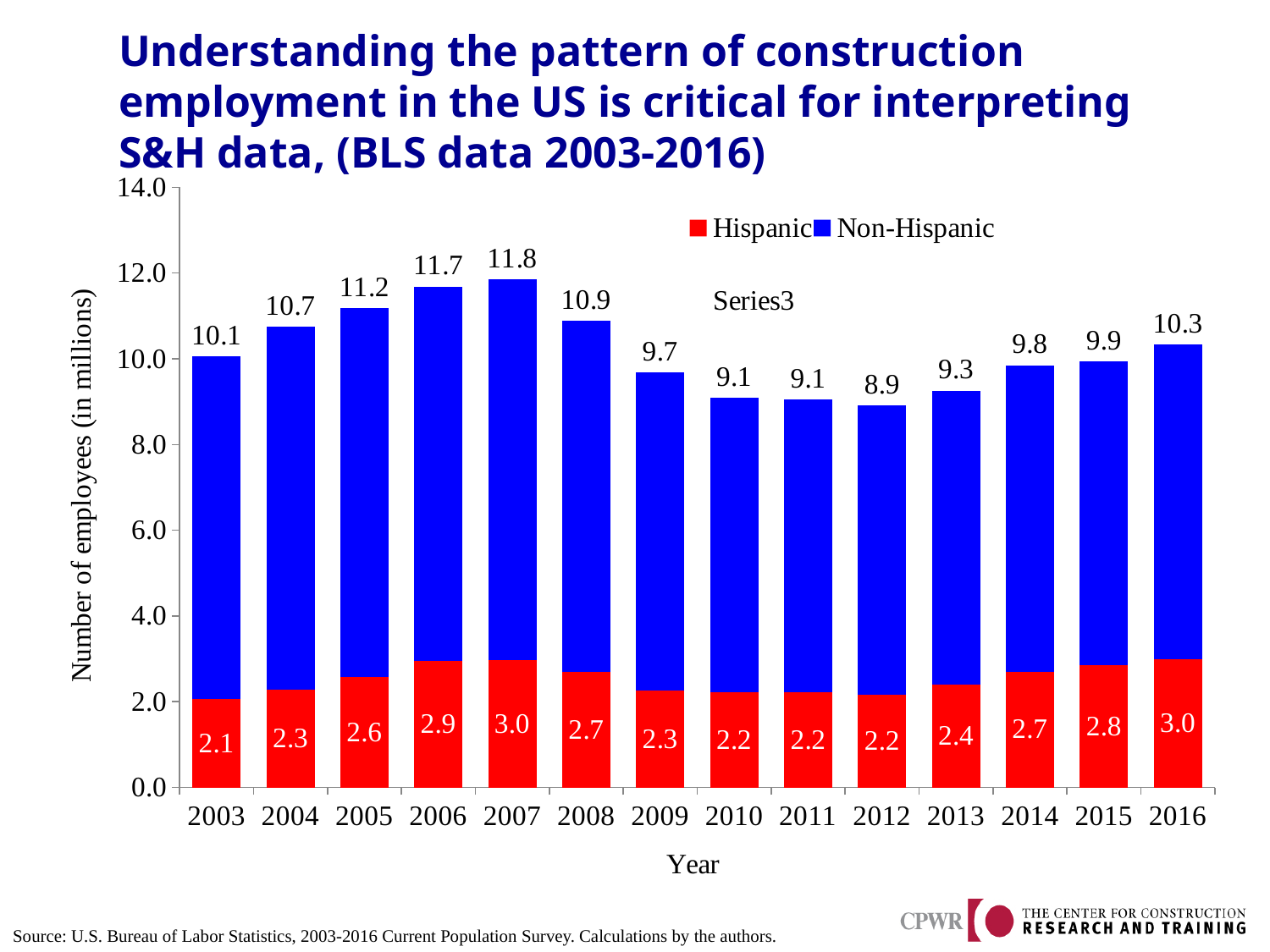
What kind of chart is shown on the slide? Stacked bar chart What is the total number of employees (in millions) shown above the bar for 2012? 8.9 Do the total values rise or fall from 2007 to 2012? fall What is the Hispanic value for 2007? 3.0 How many series does the legend list? 2 How many years are shown on the x axis? 14 Which year has the highest total number of employees? 2007 What colour represents the Hispanic series? Red Is the Non-Hispanic value for 2007 greater or less than 8.0? greater Which year has the lowest total number of employees? 2012 Which is larger, the Hispanic value for 2006 or the Hispanic value for 2010? 2006 What is the difference between the total for 2007 and the total for 2012? 2.9